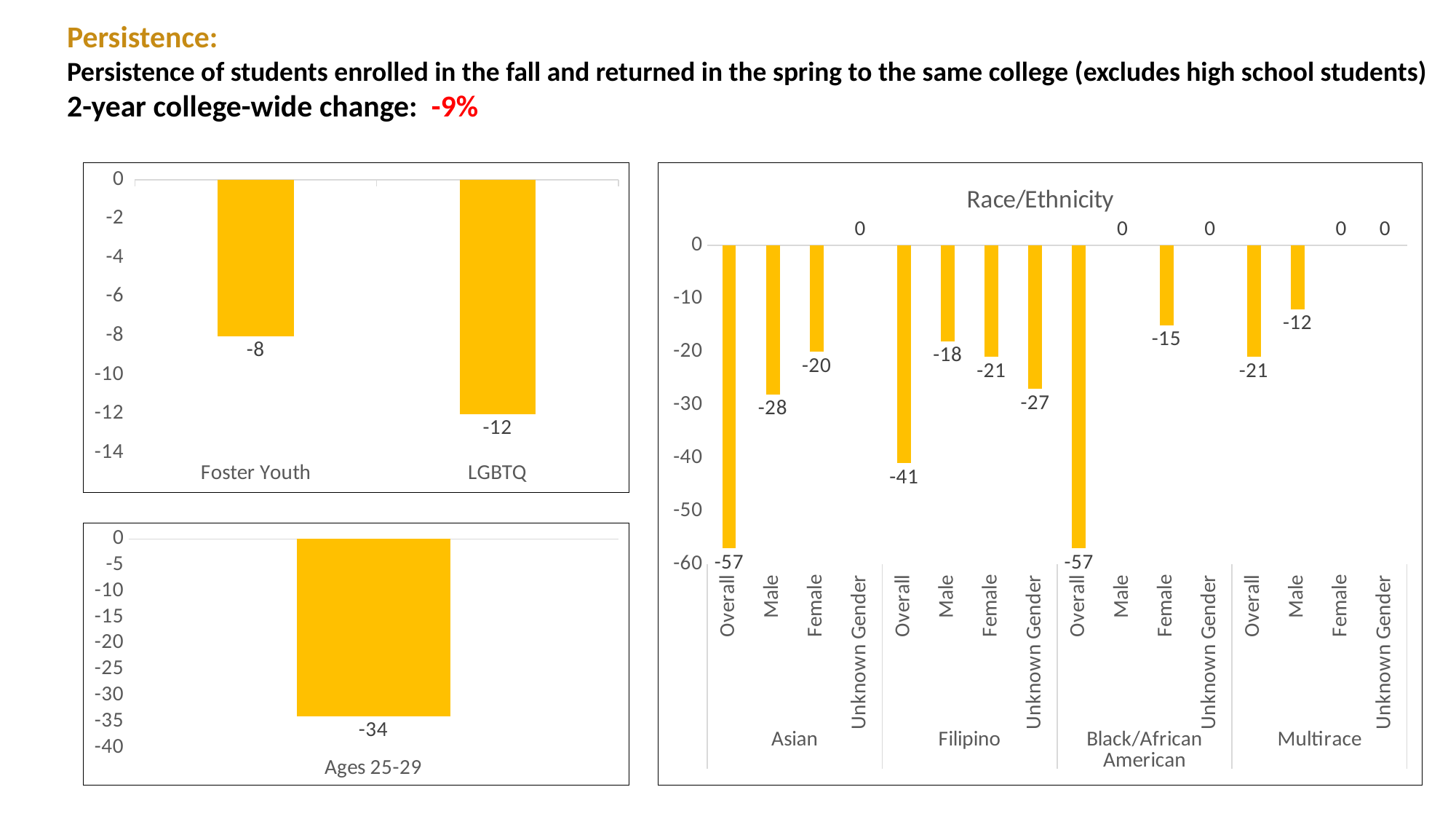
In the Race/Ethnicity chart, what is the value for Multirace Male? -12 In the bottom-left chart, what is the value for Ages 25-29? -34 In the Race/Ethnicity chart, what is the value for Asian Male? -28 In the Race/Ethnicity chart, which Filipino category has the lowest value? Overall In the Race/Ethnicity chart, how many race/ethnicity groups are shown? 4 In the top-left chart, what is the value for LGBTQ? -12 In the Race/Ethnicity chart, what is the value for Black/African American Female? -15 In the top-left chart, what is the value for Foster Youth? -8 In the Race/Ethnicity chart, what is the value for Filipino Unknown Gender? -27 What type of chart is the Race/Ethnicity chart? Bar chart In the top-left chart, what is the difference between the Foster Youth and LGBTQ values? 4 In the Race/Ethnicity chart, what is the difference between the Asian Overall and Filipino Overall values? 16